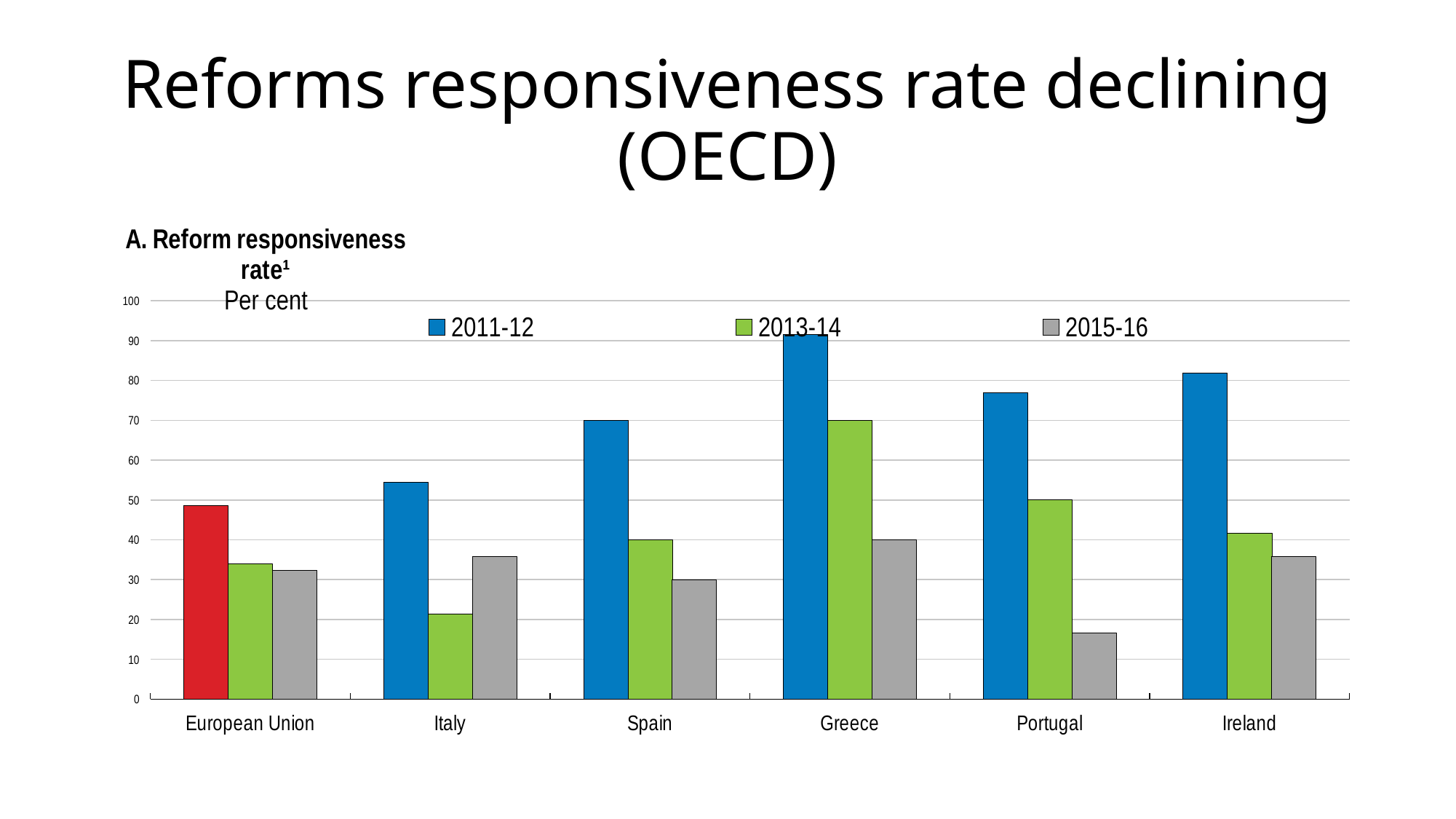
How many countries/regions are shown on the x axis? 6 Which is larger for 2011-12: Ireland or Portugal? Ireland Is the value for Italy in 2013-14 greater or less than 30? less What colour is the 2011-12 bar for the European Union? red Which category has the lowest value for 2015-16? Portugal For Greece, do the values rise or fall from 2011-12 to 2015-16? fall Which category has the highest value for 2011-12? Greece How many series does the legend list? 3 Is the value for Portugal in 2015-16 greater or less than 20? less Is the value for Greece in 2011-12 greater or less than 80? greater Which category has the lowest value for 2011-12? European Union What kind of chart is shown on the slide? bar chart